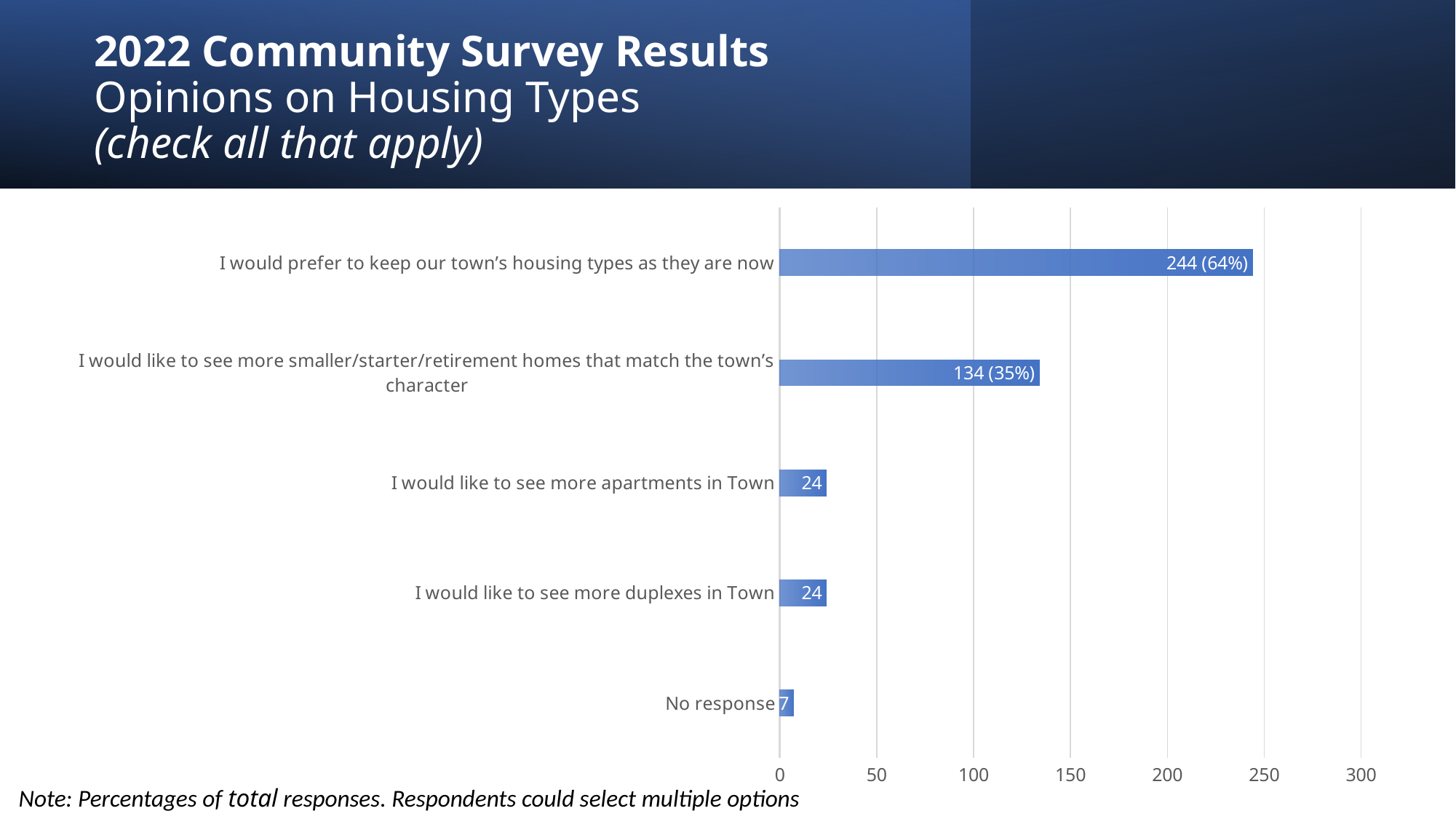
How many responses were there for "I would like to see more apartments in Town"? 24 How many responses were there for "I would prefer to keep our town's housing types as they are now"? 244 (64%) Which category has the highest number of responses? I would prefer to keep our town's housing types as they are now Is the value for "I would like to see more duplexes in Town" greater or less than 50? less What value is shown for "I would like to see more smaller/starter/retirement homes that match the town's character"? 134 (35%) What is the maximum value shown on the horizontal axis? 300 How many responses were there for "No response"? 7 What kind of chart is shown on the slide? Bar chart How many categories are shown in the chart? 5 What is the difference in responses between keeping housing types as they are now and seeing more smaller/starter/retirement homes? 110 Which has more responses: more apartments in Town or No response? I would like to see more apartments in Town Which category has the lowest number of responses? No response